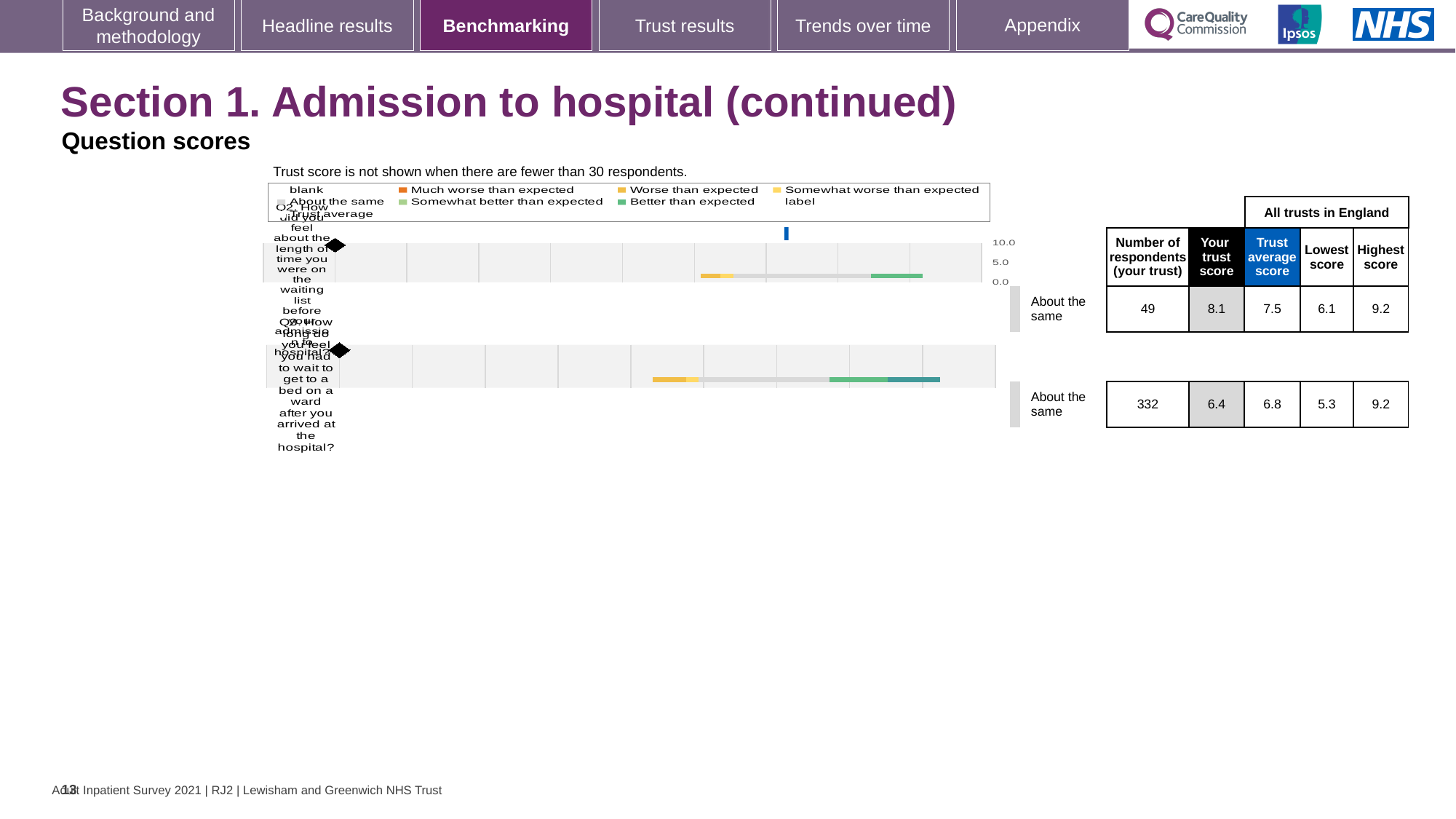
What is the trust score for Q3 (how long did you feel you had to wait to get to a bed on a ward)? 6.4 What is the trust score for Q2 (how did you feel about the length of time on the waiting list)? 8.1 What kind of chart is used to show the question scores on this slide? bar chart How many respondents answered Q2 for this trust? 49 Which question has the higher trust score, Q2 or Q3? Q2 What is the trust average score for Q3? 6.8 What is the difference between the highest and lowest scores for Q3? 3.9 How many questions (chart rows) are shown on the slide? 2 What is the highest score across all trusts in England for Q3? 9.2 What benchmark category is shown for Q2? About the same What is the difference between the trust score and the trust average score for Q2? 0.6 What is the maximum value shown on the chart's score axis? 10.0